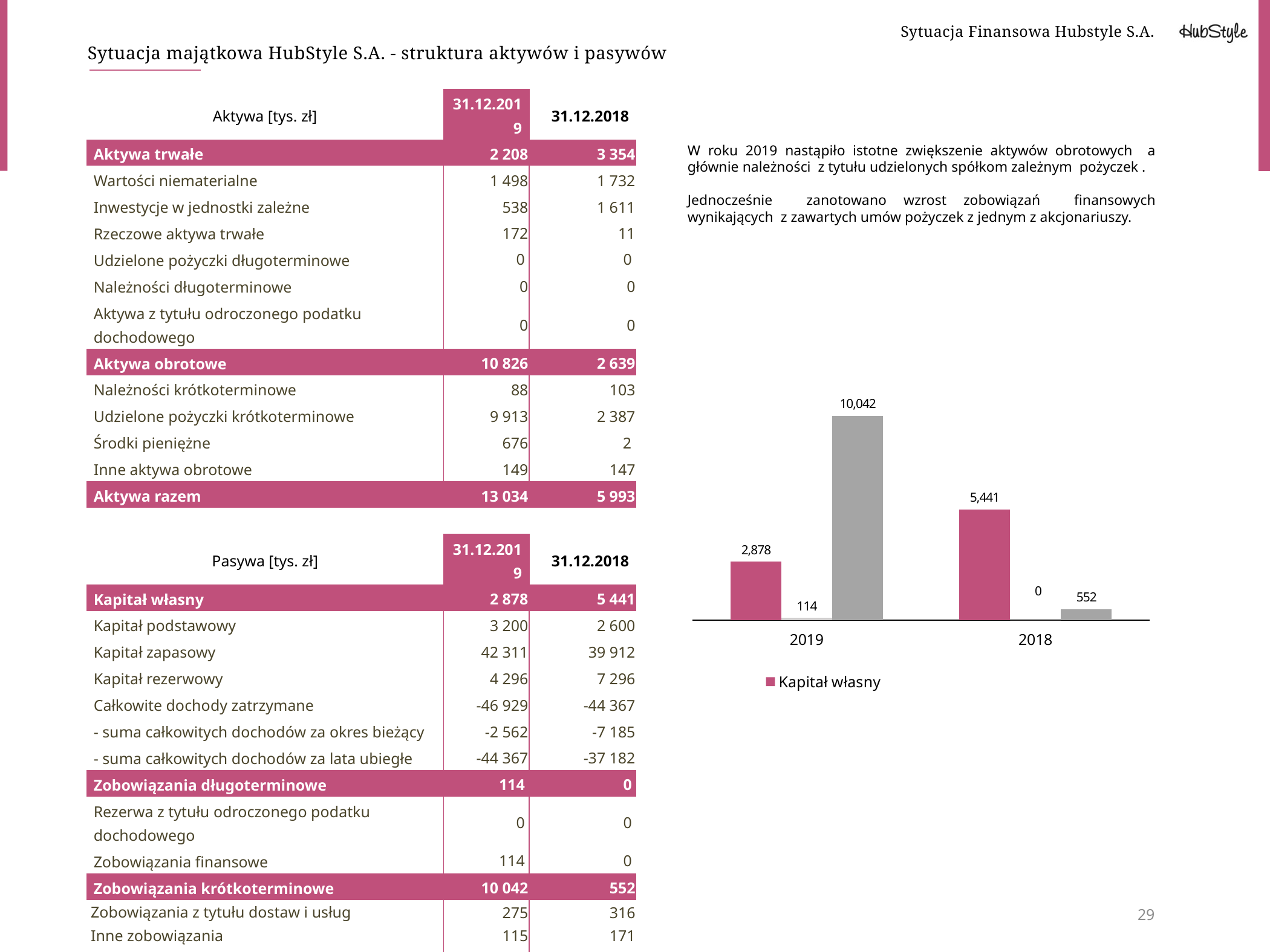
What is the value of Kapitał własny for 2018 in the bar chart? 5,441 How many years (categories) are shown on the x axis of the chart? 2 What type of chart is shown on the slide? bar chart For 2019, which is larger in the chart: the Kapitał własny bar or the grey bar? the grey bar What value is labelled on the small middle bar for 2019 in the chart? 114 How many series does the chart's legend list? 1 What value is labelled on the tallest grey bar for 2019 in the chart? 10,042 What is the value of Kapitał własny for 2019 in the bar chart? 2,878 In which year is Kapitał własny higher in the chart, 2019 or 2018? 2018 What is the difference between Kapitał własny in 2018 and in 2019 according to the chart? 2,563 What value is labelled on the grey bar for 2018 in the chart? 552 What is the difference between the grey bar values for 2019 and 2018 in the chart? 9,490